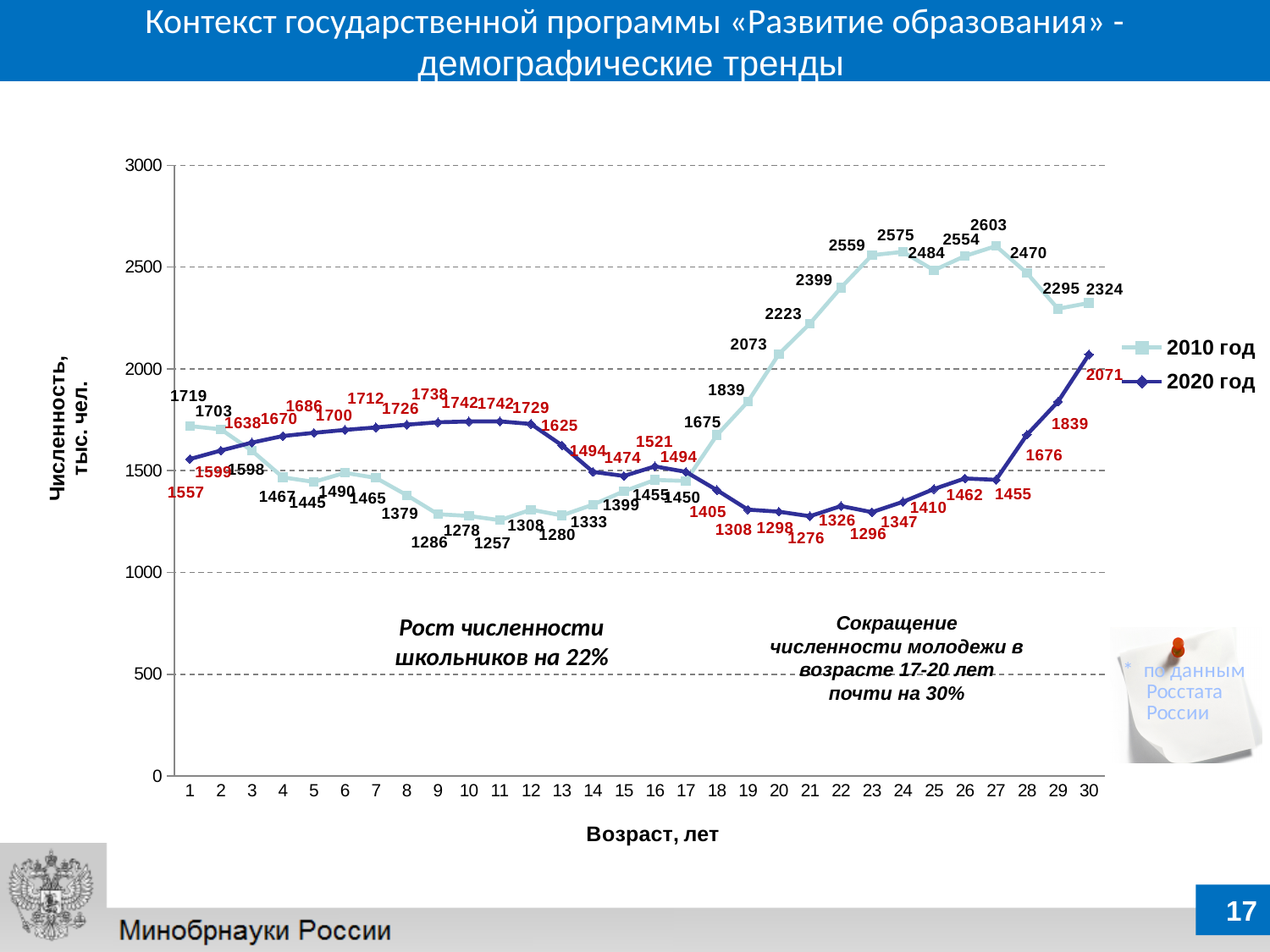
What is the value for the 2010 год series at age 11? 1257 What is the label of the x axis? Возраст, лет What is the value for the 2020 год series at age 1? 1557 What is the difference between the 2010 год and 2020 год values at age 23? 1263 What is the value for the 2010 год series at age 27? 2603 Does the 2010 год series rise or fall from age 18 to age 23? rise Which series has the larger value at age 10, 2010 год or 2020 год? 2020 год At which age does the 2020 год series reach its lowest value? 21 How many age categories are shown on the x axis? 30 At which age does the 2010 год series reach its highest value? 27 How many series does the legend list? 2 What type of chart is shown on the slide? line chart